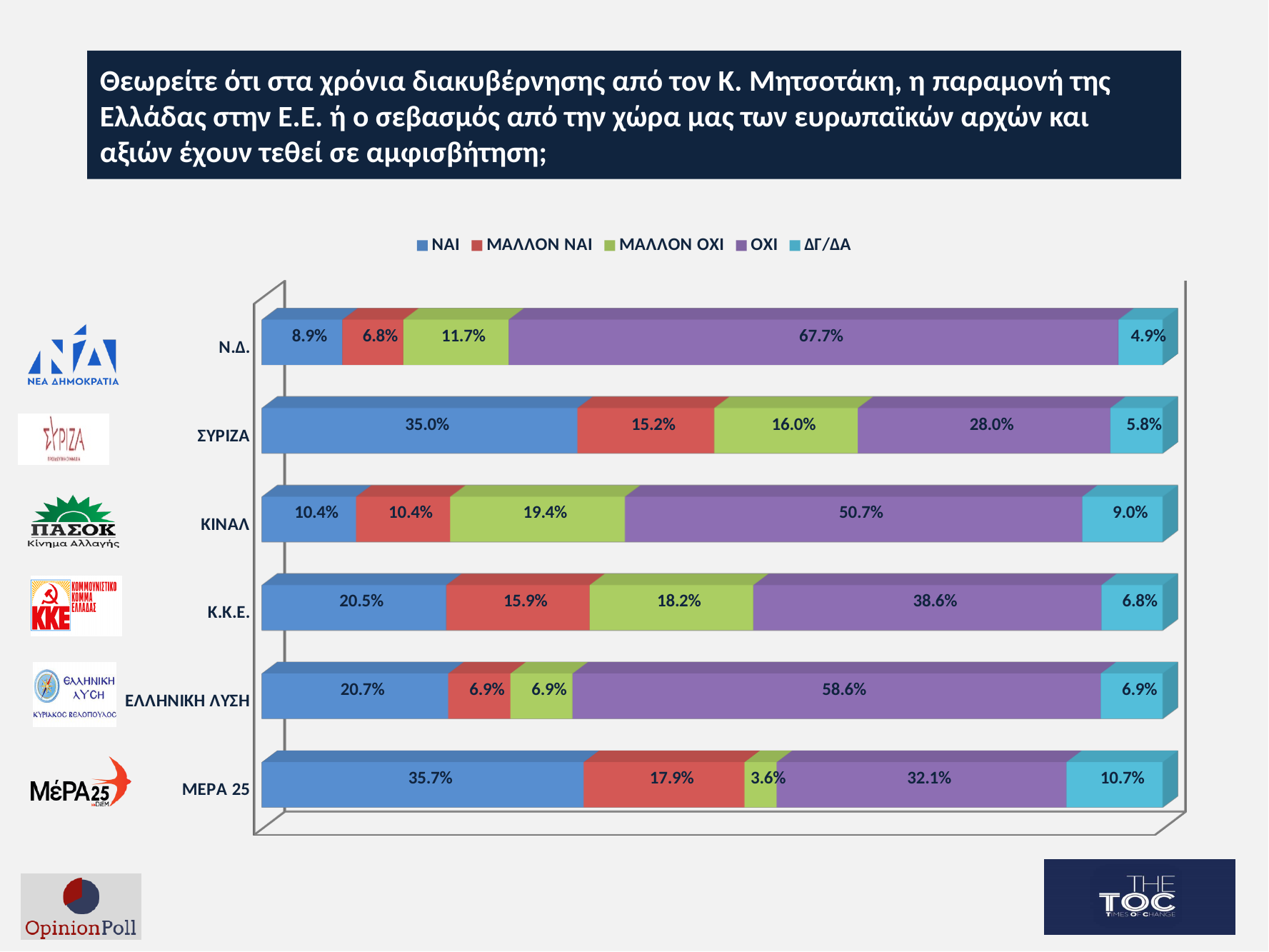
Which party has the lowest ΜΑΛΛΟΝ ΟΧΙ value? ΜΕΡΑ 25 Which is larger: the ΟΧΙ value for ΚΙΝΑΛ or the ΟΧΙ value for Κ.Κ.Ε.? ΚΙΝΑΛ Which party has the highest ΟΧΙ value? Ν.Δ. What kind of chart is shown on the slide? Stacked bar chart How many series does the legend list? 5 What is the ΟΧΙ value for Ν.Δ.? 67.7% What colour represents the ΟΧΙ series in the chart? Purple What is the ΝΑΙ value for ΣΥΡΙΖΑ? 35.0% What is the ΔΓ/ΔΑ value for ΜΕΡΑ 25? 10.7% Which party has the highest ΝΑΙ value? ΜΕΡΑ 25 How many parties are shown in the chart? 6 What is the difference between the ΝΑΙ value for ΜΕΡΑ 25 and the ΝΑΙ value for Ν.Δ.? 26.8 percentage points